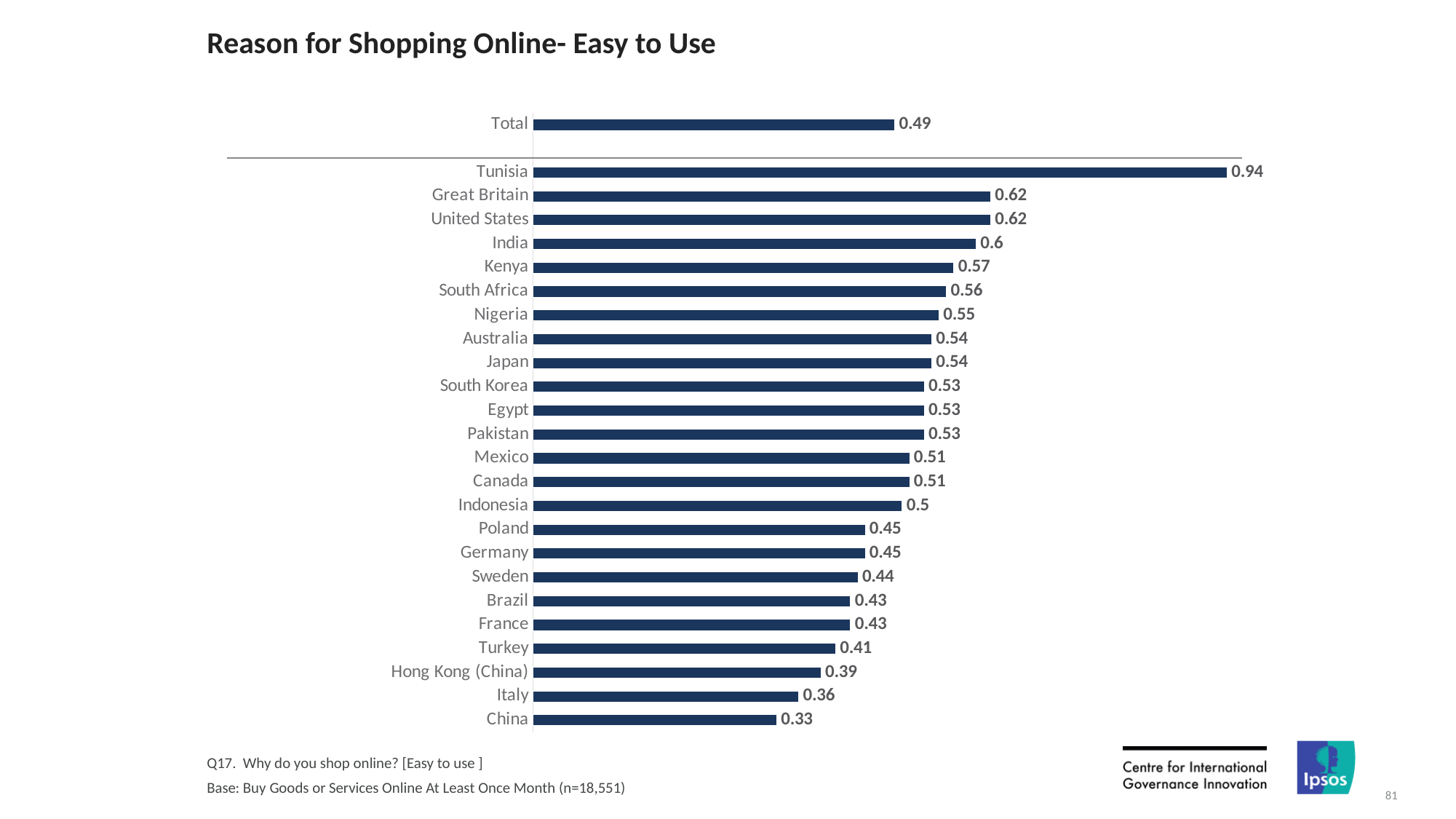
How many countries (excluding Total) are shown in the chart? 24 What is the difference between the values for India and Italy? 0.24 What kind of chart is shown on the slide? Bar chart What is the value for Tunisia? 0.94 Which country has the lowest value? China What is the value for Total? 0.49 What is the value for Hong Kong (China)? 0.39 What is the difference between the values for Tunisia and China? 0.61 Which country has the highest value? Tunisia Which has a larger value, Kenya or Turkey? Kenya Which has a larger value, Sweden or Nigeria? Nigeria What is the title of the chart? Reason for Shopping Online- Easy to Use